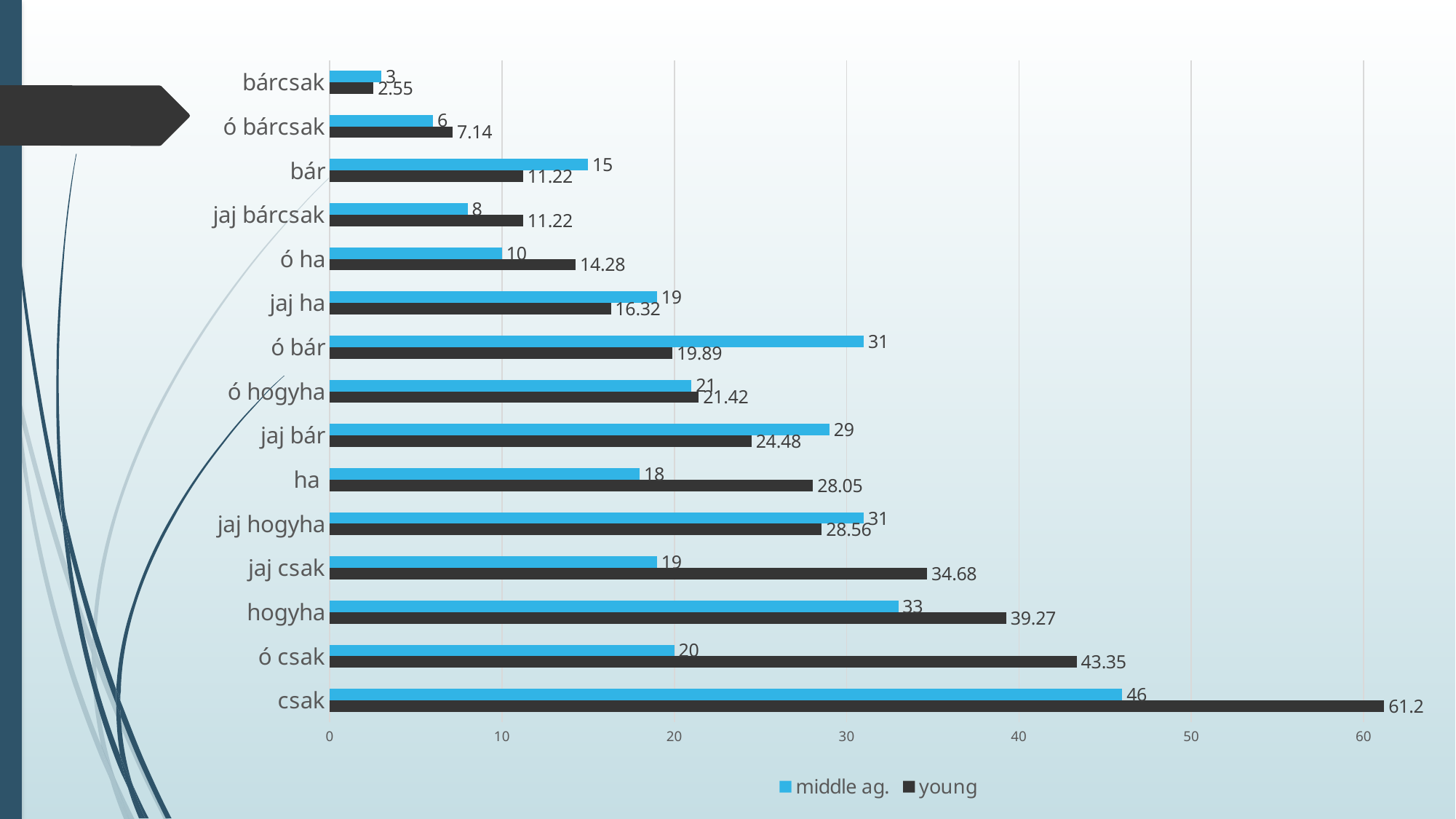
For the category "ó bár", which series has the larger value, "middle ag." or "young"? middle ag. What is the value for "middle ag." for the category "hogyha"? 33 Which category has the lowest value for "middle ag."? bárcsak What is the value for "young" for the category "ó ha"? 14.28 How many categories are plotted on the chart? 15 What kind of chart is shown on the slide? bar chart What is the difference between the "young" and "middle ag." values for "ó csak"? 23.35 Which category has the highest value for "young"? csak How many series does the legend list? 2 Is the "young" value for "jaj csak" greater or less than 30? greater What is the value for "young" for the category "csak"? 61.2 Which colour represents the "young" series in the legend? dark grey/black